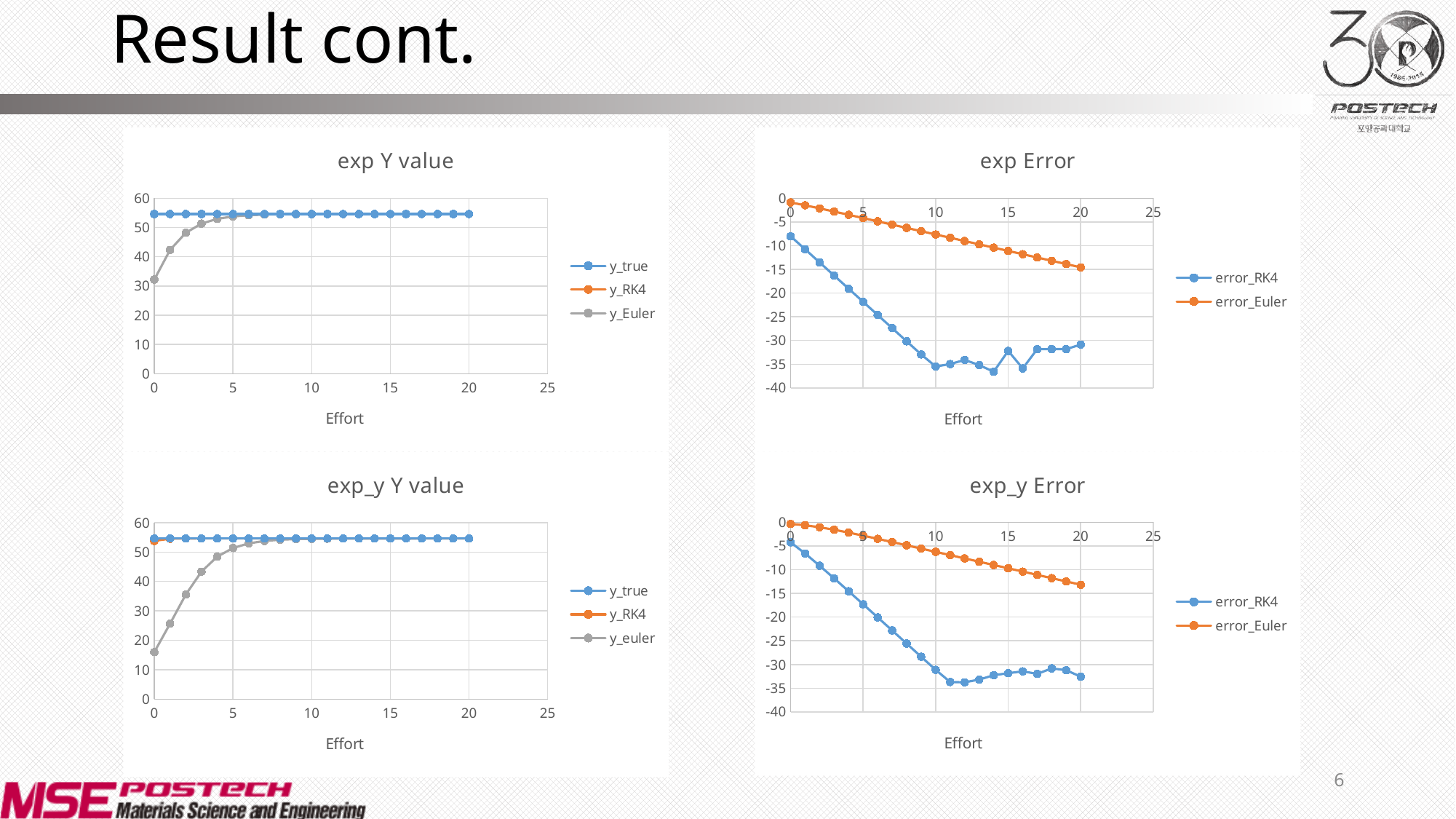
How many data points does the y_true series have in the "exp_y Y value" chart? 21 In the "exp_y Error" chart, is the error_RK4 value at Effort 20 greater or less than -30? less In the "exp Error" chart, is the error_RK4 value at Effort 10 greater or less than -30? less In the "exp Error" chart, is the error_Euler value at Effort 20 greater or less than -20? greater In the "exp Error" chart, does the error_Euler series rise or fall as Effort increases? Fall How many series does the legend of the "exp Y value" chart list? 3 What are the legend entries of the "exp_y Y value" chart? y_true, y_RK4, y_euler What kind of chart is the "exp Y value" chart? Line chart In the "exp Y value" chart, does the y_Euler series rise or fall as Effort increases? Rise In the "exp Error" chart, which series has the lower value at Effort 20, error_RK4 or error_Euler? error_RK4